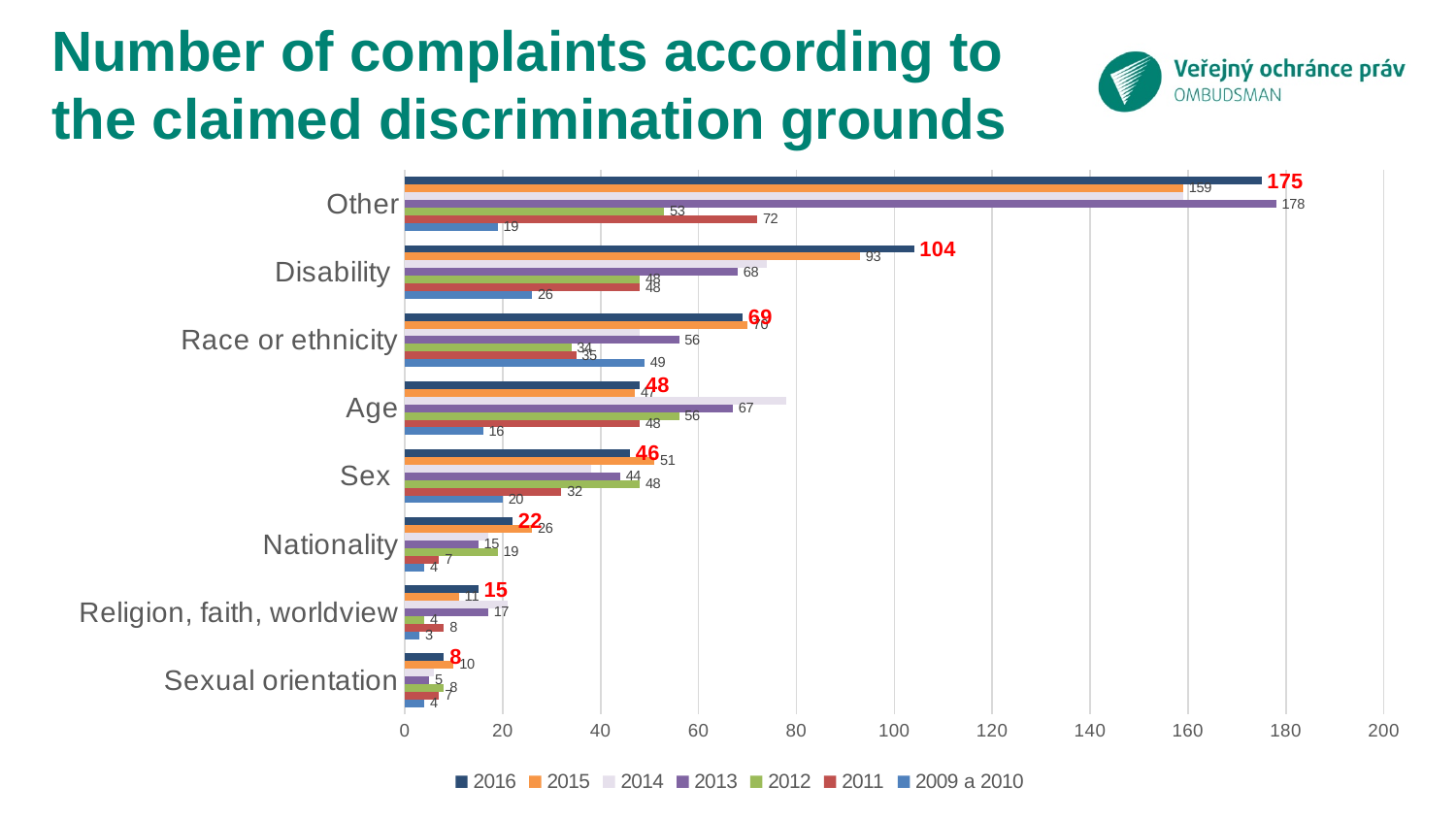
What is the difference between the 2016 values for 'Other' and 'Disability'? 71 Is the 2014 value for 'Disability' greater or less than 60? greater How many discrimination grounds (categories) are shown on the chart? 8 What is the number of complaints for 'Disability' in 2016? 104 What is the number of complaints for 'Other' in 2013? 178 What kind of chart is shown on the slide? Bar chart How many series does the legend list? 7 Which discrimination ground has the highest number of complaints in 2016? Other For 'Age', which is larger: the 2016 value or the 2013 value? 2013 What is the number of complaints for 'Other' in 2016? 175 Which discrimination ground has the lowest number of complaints in 2016? Sexual orientation What is the number of complaints for 'Disability' in 2015? 93